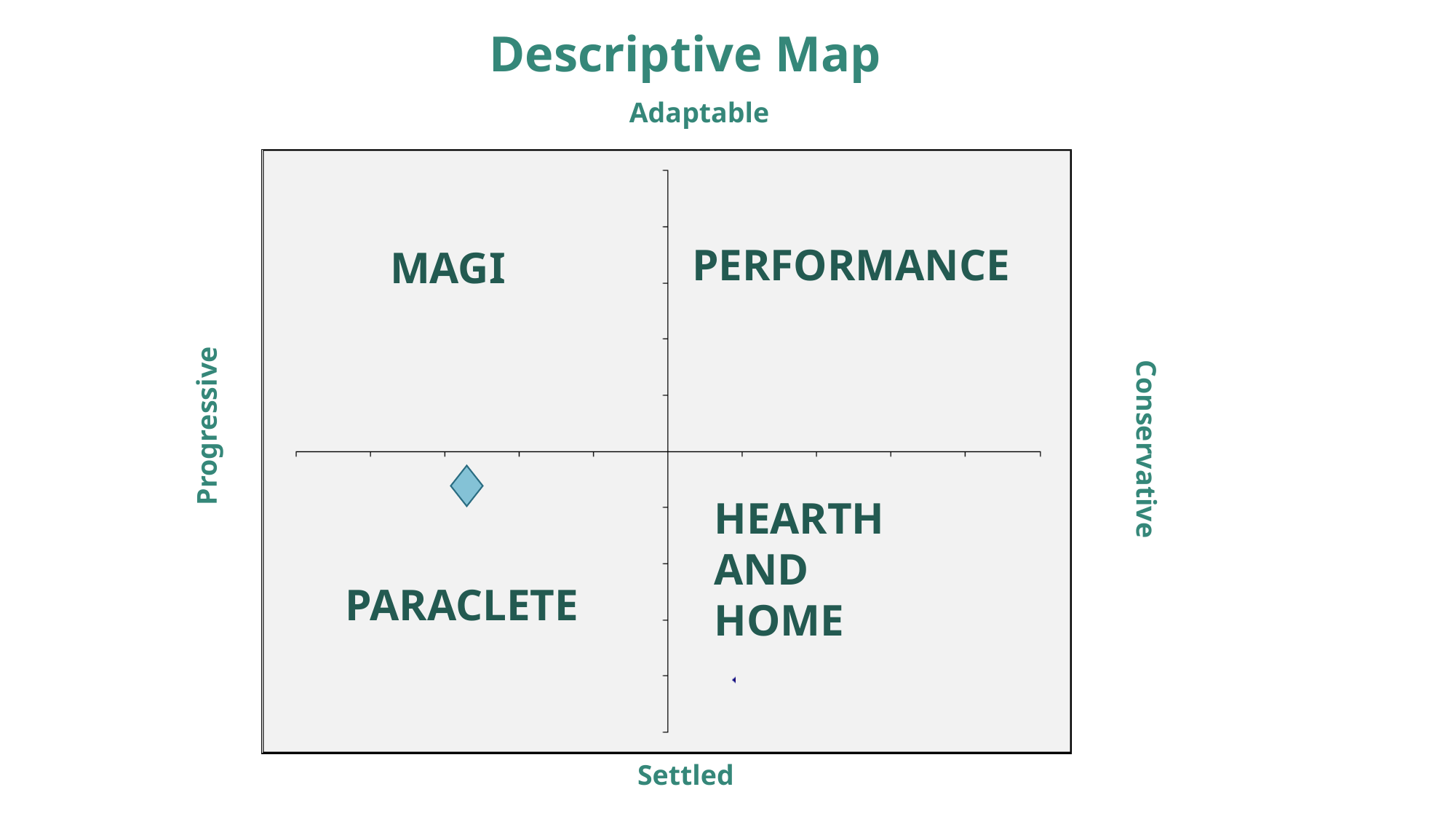
How many labelled quadrants does the chart have? 4 Which quadrant label is in the bottom-right of the chart? HEARTH AND HOME What kind of chart is this? scatter chart In which labelled quadrant does the blue diamond marker lie? PARACLETE Is the blue diamond marker on the Adaptable side or the Settled side of the horizontal axis? Settled Which label appears at the top of the vertical axis? Adaptable Which quadrant label is in the top-right of the chart? PERFORMANCE Is the blue diamond marker on the Progressive side or the Conservative side of the vertical axis? Progressive What is the title of the chart? Descriptive Map Which quadrant label is in the top-left of the chart? MAGI